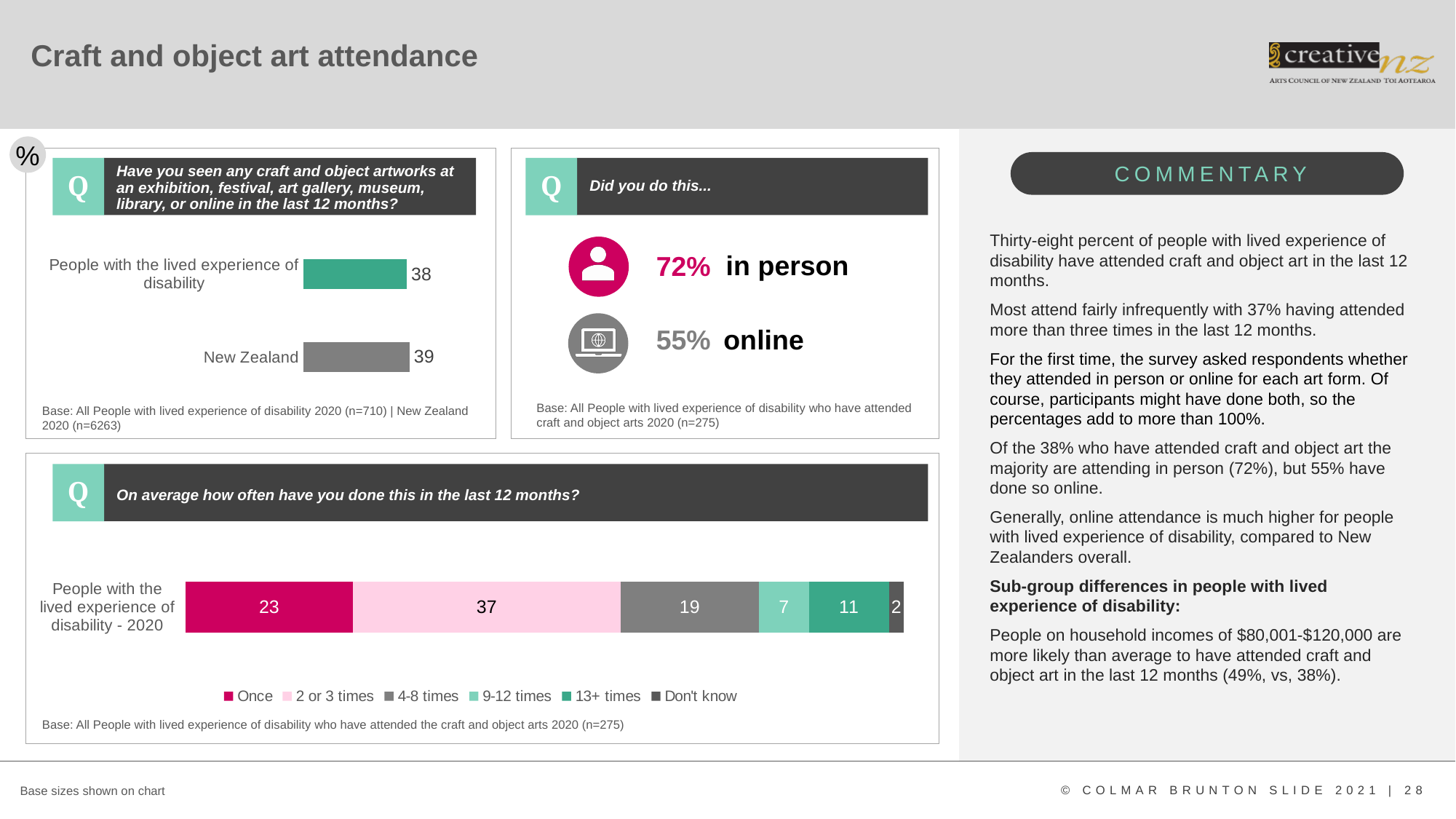
In the bottom chart on how often people have done this in the last 12 months, which frequency category has the lowest value? Don't know In the bottom chart on how often people have done this in the last 12 months, what is the difference between the 4-8 times value and the 9-12 times value? 12 In the bottom chart on how often people have done this in the last 12 months, which frequency category has the highest value? 2 or 3 times In the bottom chart on how often people have done this in the last 12 months, how many series does the legend list? 6 In the top-left chart on craft and object art attendance, what is the value for New Zealand? 39 In the bottom chart on how often people have done this in the last 12 months, what is the value for Once? 23 In the bottom chart on how often people have done this in the last 12 months, what is the value for 13+ times? 11 In the bottom chart on how often people have done this in the last 12 months, what is the value for 2 or 3 times? 37 In the top-left chart on craft and object art attendance, what is the difference between the New Zealand value and the value for People with the lived experience of disability? 1 In the top-left chart on craft and object art attendance, what is the value for People with the lived experience of disability? 38 What kind of chart is the top-left chart on craft and object art attendance? Bar chart In the top-left chart on craft and object art attendance, how many categories are shown? 2